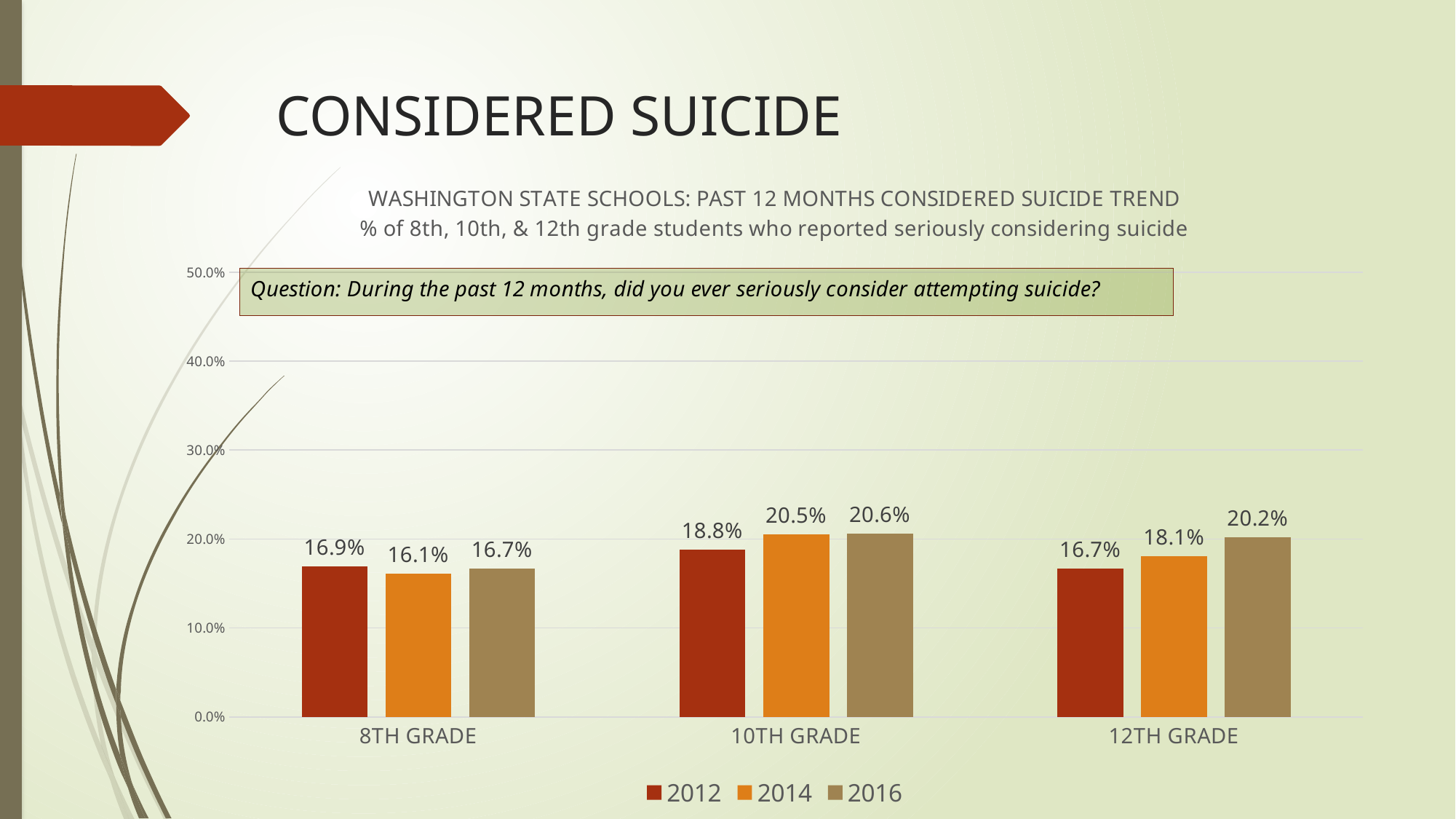
What is the difference between the 2016 and 2012 values for 12th grade? 3.5% What is the value for 8th grade in 2014? 16.1% How many grade categories are shown on the x axis? 3 What is the value for 12th grade in 2016? 20.2% Is the value for 12th grade in 2012 greater or less than 20.0%? less What is the value for 10th grade in 2014? 20.5% What percentage of 8th grade students reported seriously considering suicide in 2012? 16.9% Which is larger for 10th grade: the 2012 value or the 2014 value? 2014 What kind of chart is shown on the slide? bar chart Which grade has the lowest value in 2014? 8th grade Which grade has the highest value in 2016? 10th grade How many series does the legend list? 3